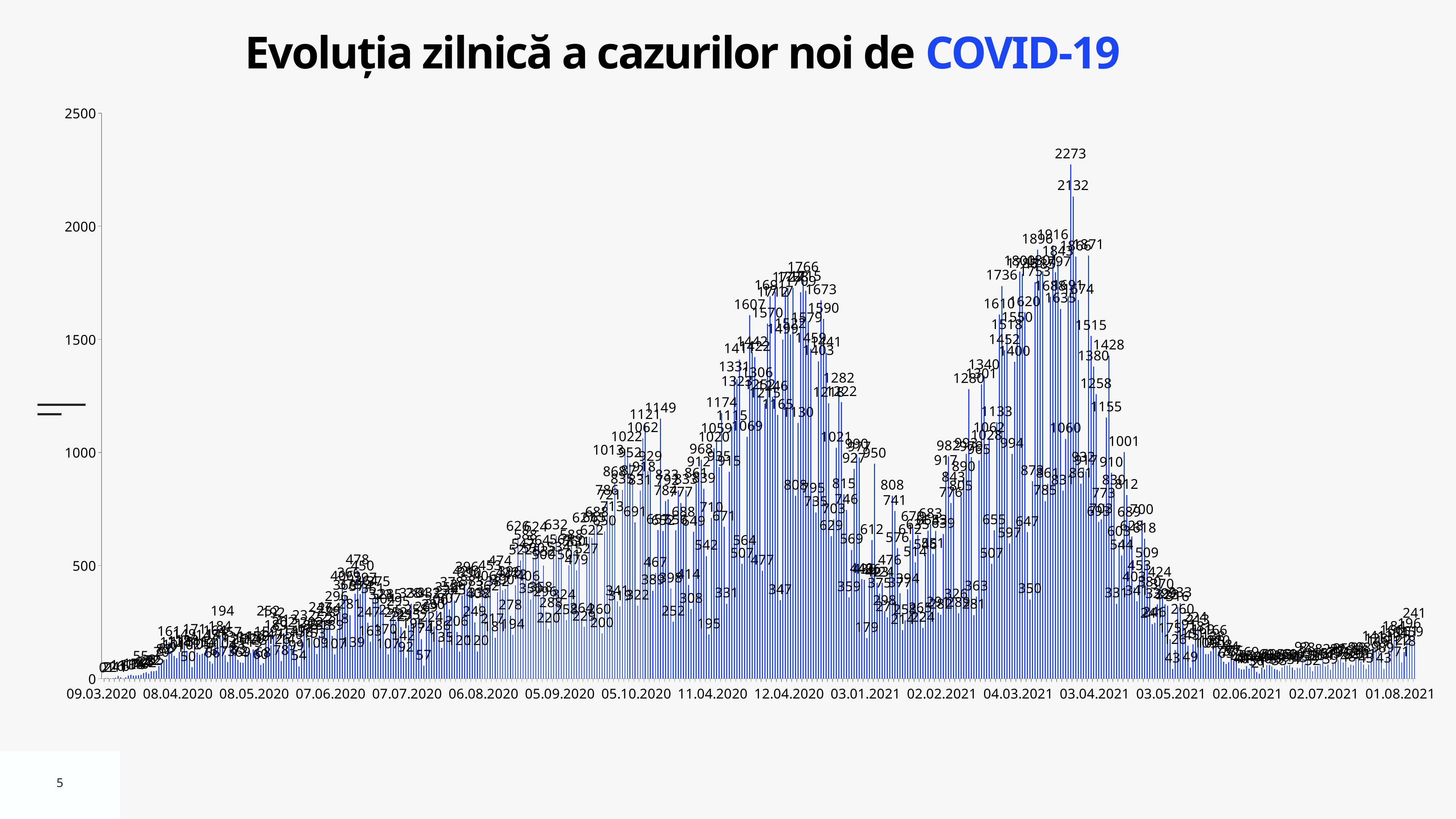
What is the highest value labelled in the wave around 12.04.2020? 1766 Is the last bar on the chart, at 01.08.2021, greater or less than 500? less What is the first date shown on the x axis? 09.03.2020 What is the highest daily value labelled on the chart? 2273 What is the second-highest daily value labelled on the chart, next to the 2273 peak? 2132 Is the highest bar on the chart greater or less than 2000? greater Is the highest bar in the wave around 12.04.2020 greater or less than 2000? less Do the values rise or fall between 03.04.2021 and 02.06.2021? fall What is the difference between the two highest labelled values, 2273 and 2132? 141 What kind of chart is shown on the slide? bar chart What is the title of the chart? Evoluția zilnică a cazurilor noi de COVID-19 What is the maximum value shown on the y axis? 2500